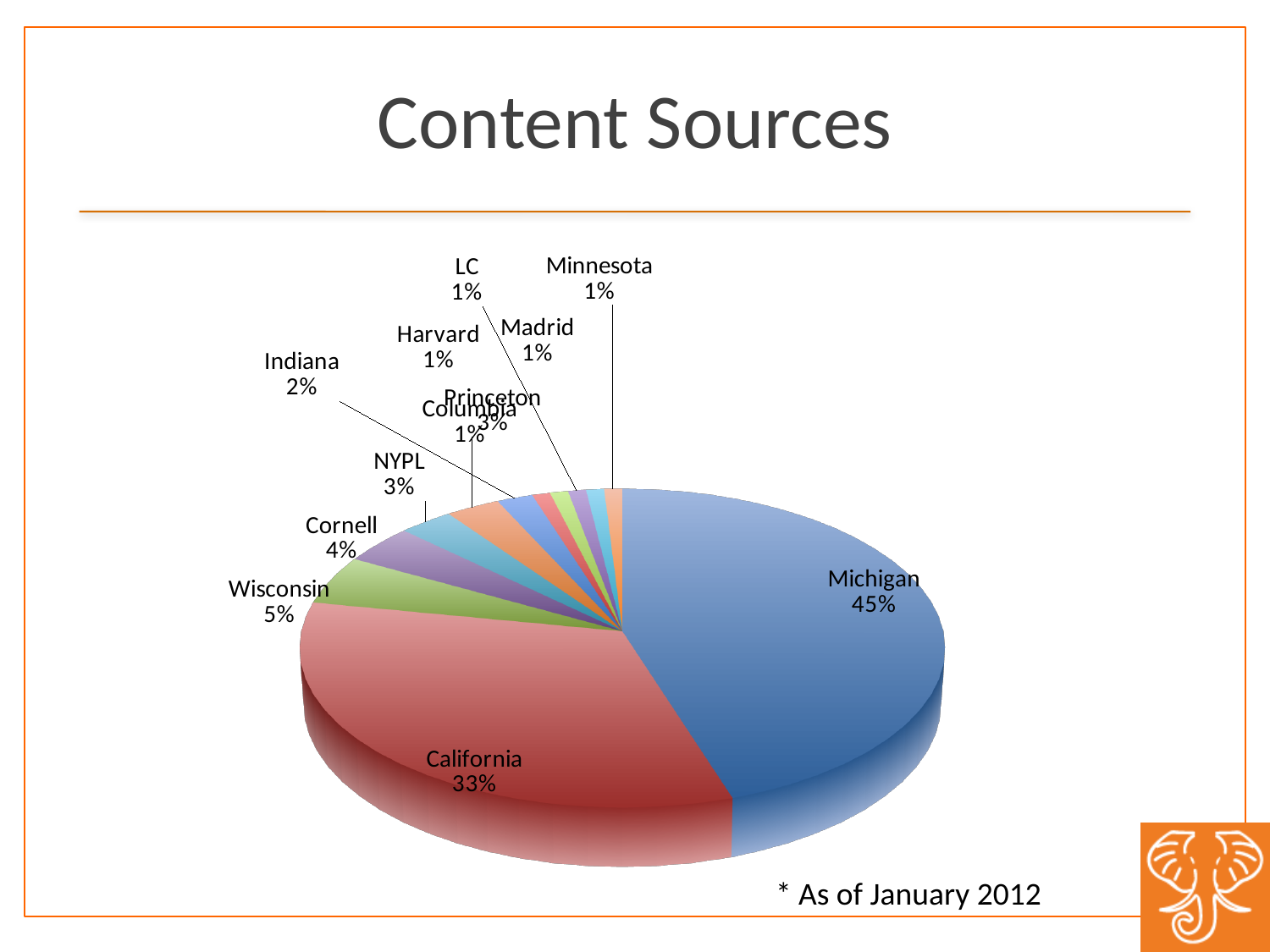
What share of the pie does California have? 33% Which has a larger share, Wisconsin or Cornell? Wisconsin What percentage is shown for Cornell? 4% What date does the footnote say the data is as of? January 2012 What is the difference in percentage points between Michigan's share and California's share? 12% What is the title of the chart on the slide? Content Sources What percentage is shown for NYPL? 3% What kind of chart is shown on the slide? pie chart What percentage is shown for Indiana? 2% What percentage is shown for Wisconsin? 5% What share of the pie does Michigan have? 45% Which content source has the largest share of the pie? Michigan